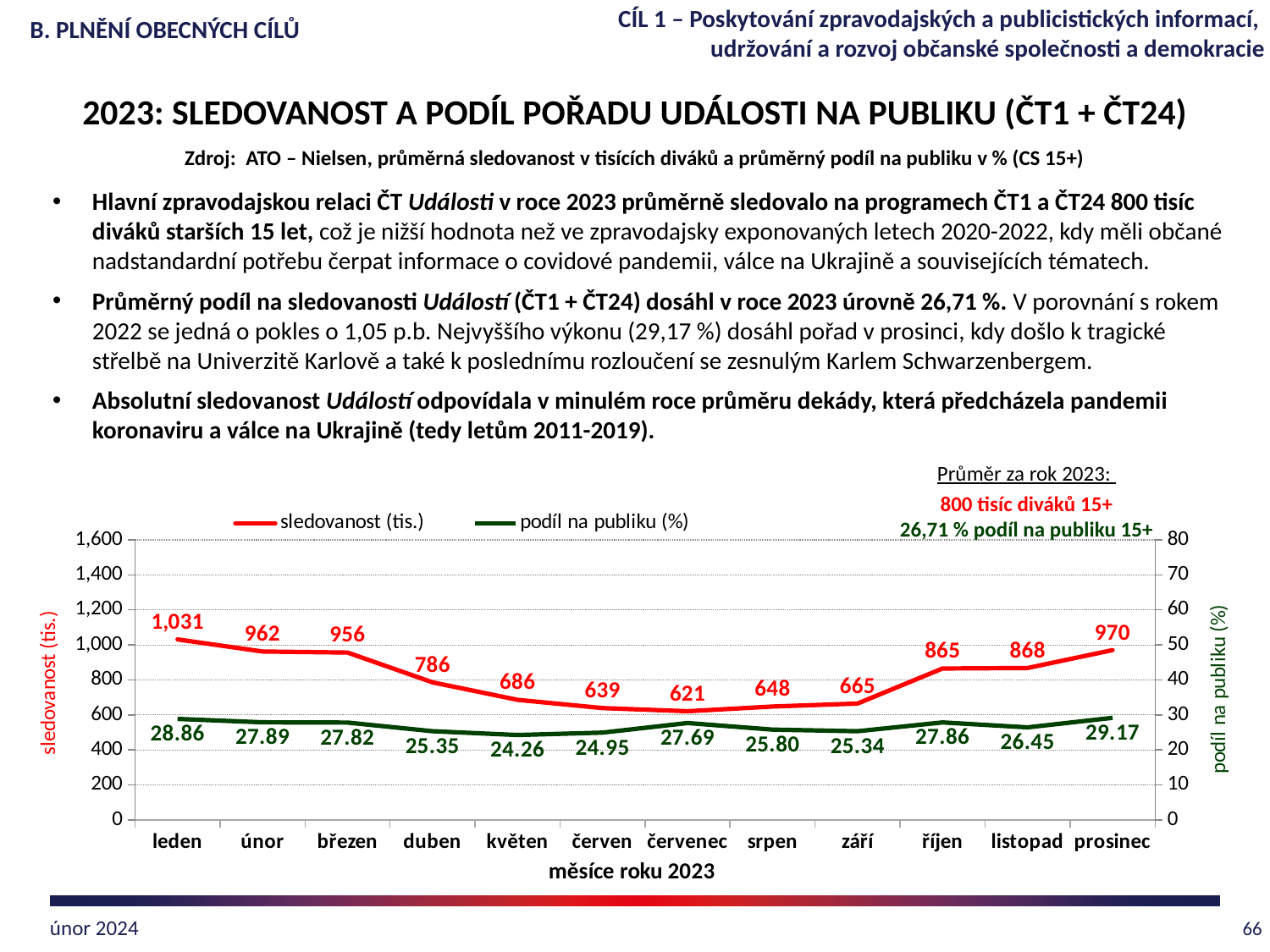
How many months are plotted along the x axis of the chart? 12 What is the value of sledovanost (tis.) for leden? 1,031 What is the difference between the sledovanost (tis.) values for leden and prosinec? 61 Which is larger, the sledovanost (tis.) value for říjen or for listopad? listopad What is the label of the x axis of the chart? měsíce roku 2023 What is the value of sledovanost (tis.) for červenec? 621 Which month has the lowest value of sledovanost (tis.)? červenec What is the value of podíl na publiku (%) for prosinec? 29.17 Which month has the lowest value of podíl na publiku (%)? květen Which month has the highest value of podíl na publiku (%)? prosinec What type of chart is shown on the slide? line chart How many series does the chart legend list? 2